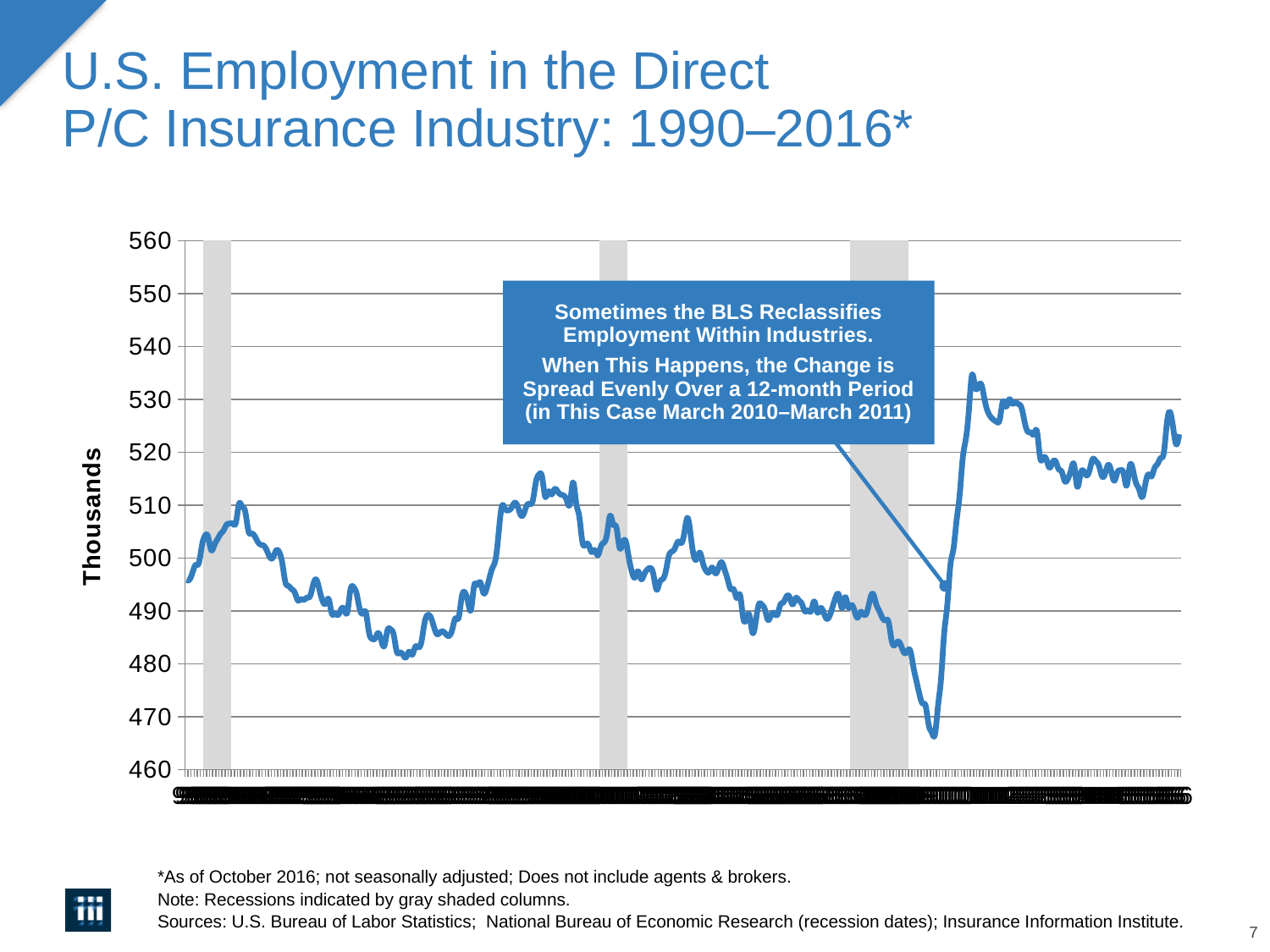
What kind of chart is shown on the slide? line chart Does the line rise or fall between the trough near the third gray shaded column and the peak immediately after it? rise Is the value at the end of the line (2016) greater or less than 510? greater What is the label on the vertical axis of the chart? Thousands What is the lowest value shown on the vertical axis? 460 What do the gray shaded columns on the chart indicate? Recessions What is the highest value shown on the vertical axis? 560 Is the lowest value reached by the line greater or less than 470? less Is the value at the start of the line (1990) greater or less than 500? less Does the line rise or fall from the peak just after the third gray shaded column to the end of the series? fall